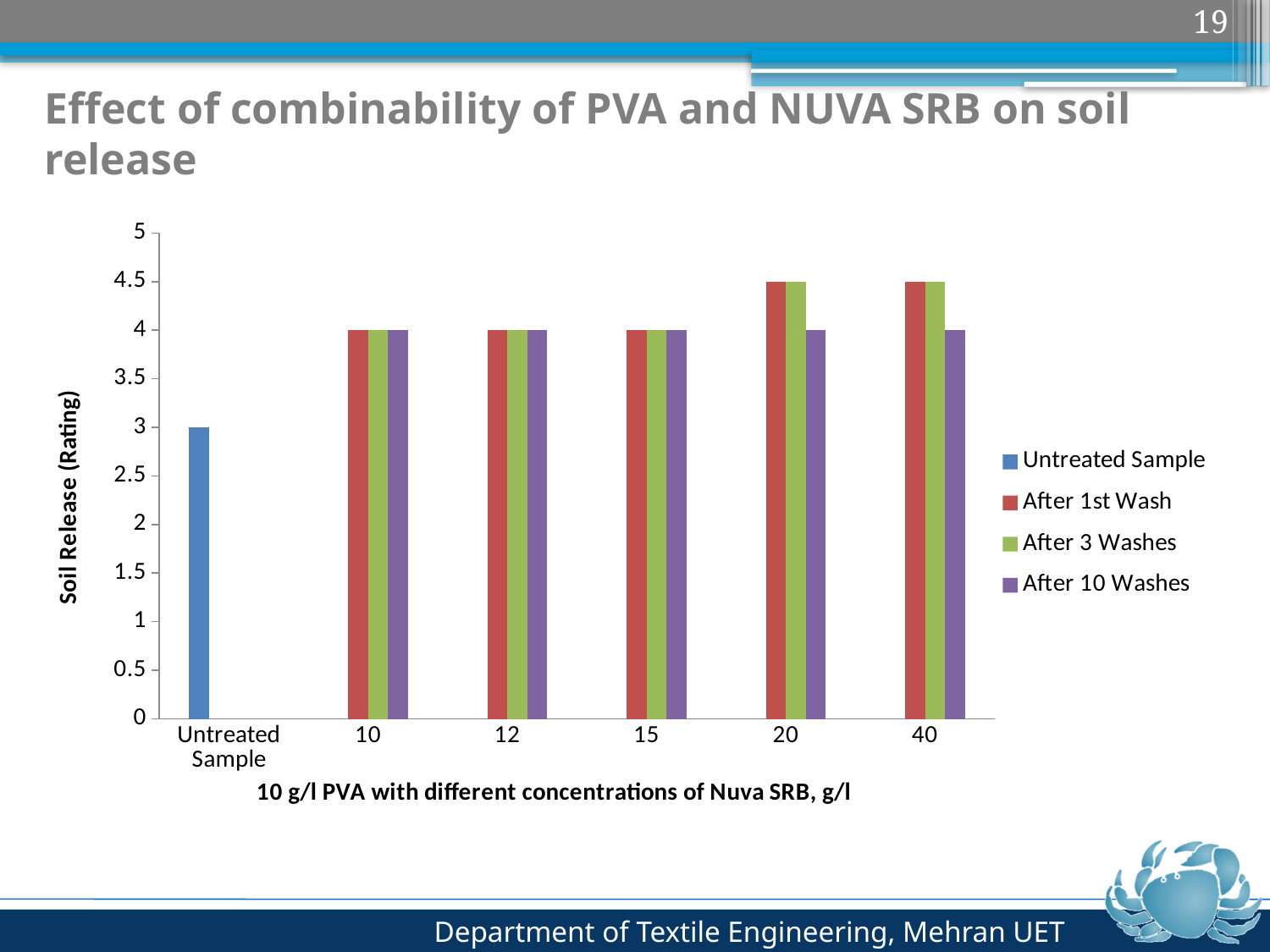
What is the soil release rating After 1st Wash at 20 g/l Nuva SRB? 4.5 How many series does the legend list? 4 Which is larger at 20 g/l Nuva SRB: the rating After 3 Washes or After 10 Washes? After 3 Washes Is the soil release rating After 1st Wash at 40 g/l greater or less than 4? greater What kind of chart is shown on the slide? bar chart What is the soil release rating After 3 Washes at 12 g/l Nuva SRB? 4 What colour represents the After 10 Washes series in the legend? purple What is the difference between the After 1st Wash rating at 20 g/l and the Untreated Sample rating? 1.5 What is the soil release rating of the Untreated Sample? 3 What is the soil release rating After 10 Washes at 40 g/l Nuva SRB? 4 What is the label of the y axis? Soil Release (Rating) How many categories are shown on the x axis? 6